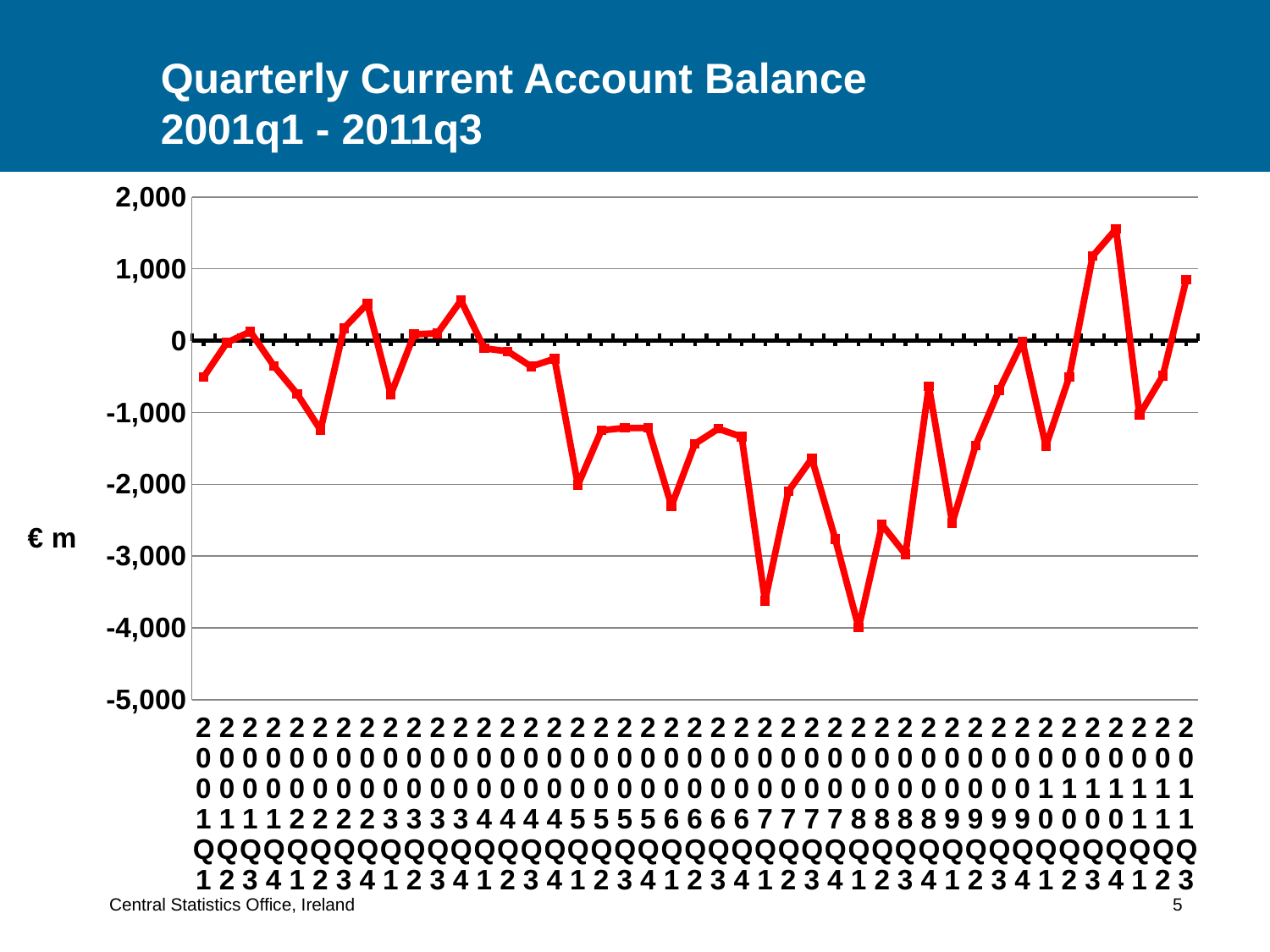
Do the values generally rise or fall from 2008Q4 to 2010Q4? rise How many quarterly data points are plotted on the chart? 43 Which quarter has the lowest current account balance on the chart? 2008Q1 What kind of chart is shown on the slide? Line chart Is the value for 2011Q3 greater or less than 0? greater Which quarter has the highest current account balance on the chart? 2010Q4 What unit label is shown on the vertical axis? € m Is the value for 2005Q1 greater or less than -1,000? less Is the value for 2010Q4 greater or less than 1,000? greater Which is larger, the value for 2010Q4 or the value for 2011Q3? 2010Q4 What is the title of the chart? Quarterly Current Account Balance 2001q1 - 2011q3